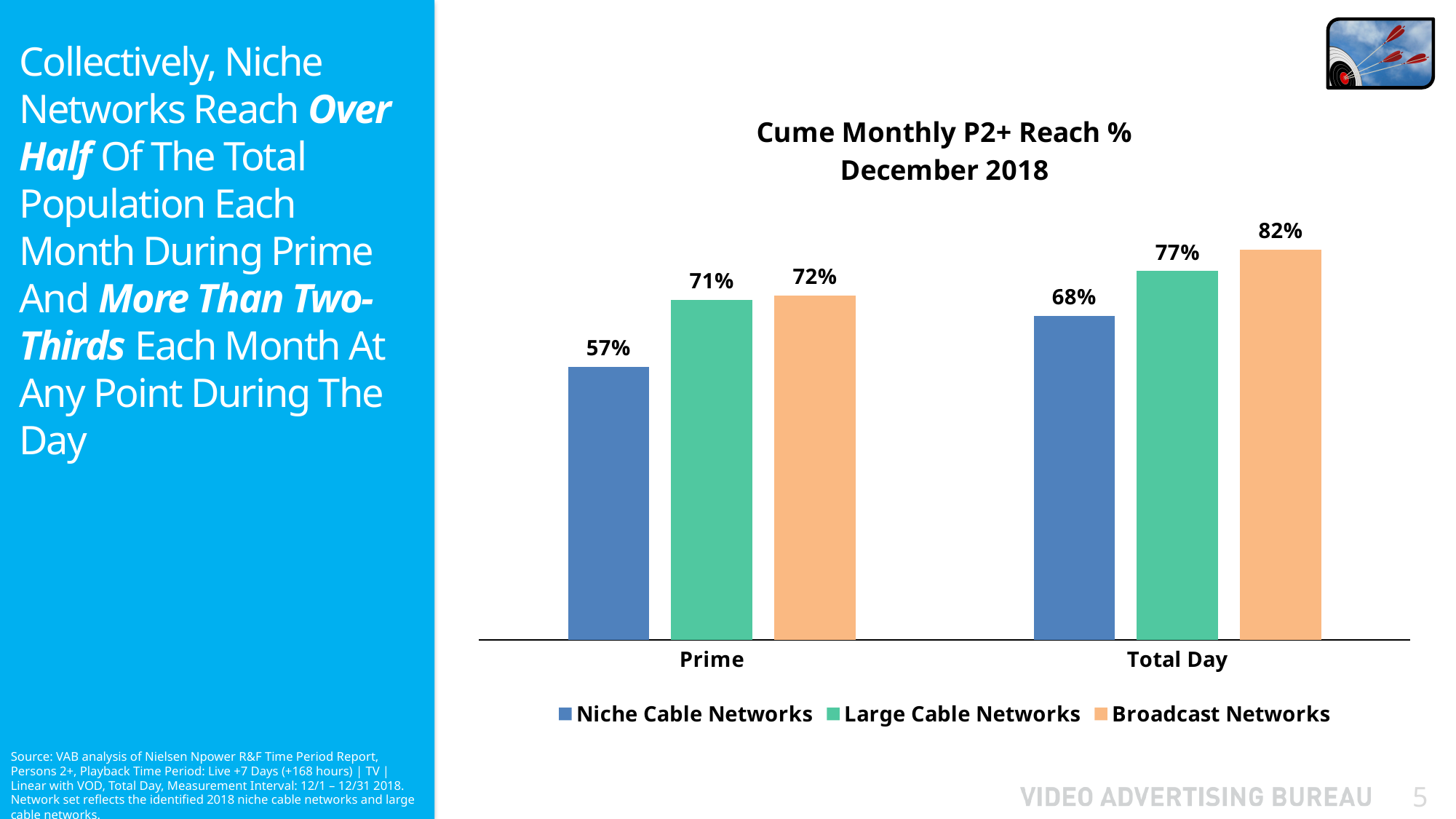
What is the title of the chart? Cume Monthly P2+ Reach % December 2018 How many series does the legend list? 3 What is the difference between Broadcast Networks and Large Cable Networks reach for Total Day? 5% What is the Cume Monthly P2+ Reach % for Niche Cable Networks during Prime? 57% What is the difference between the Total Day and Prime reach for Niche Cable Networks? 11% Which is larger: Large Cable Networks reach during Prime or Niche Cable Networks reach for Total Day? Large Cable Networks reach during Prime Which series has the highest reach during Prime? Broadcast Networks What kind of chart is shown on the slide? Bar chart What is the Cume Monthly P2+ Reach % for Broadcast Networks for Total Day? 82% How many categories are shown on the x axis? 2 What is the Cume Monthly P2+ Reach % for Large Cable Networks for Total Day? 77% Which series has the lowest reach for Total Day? Niche Cable Networks